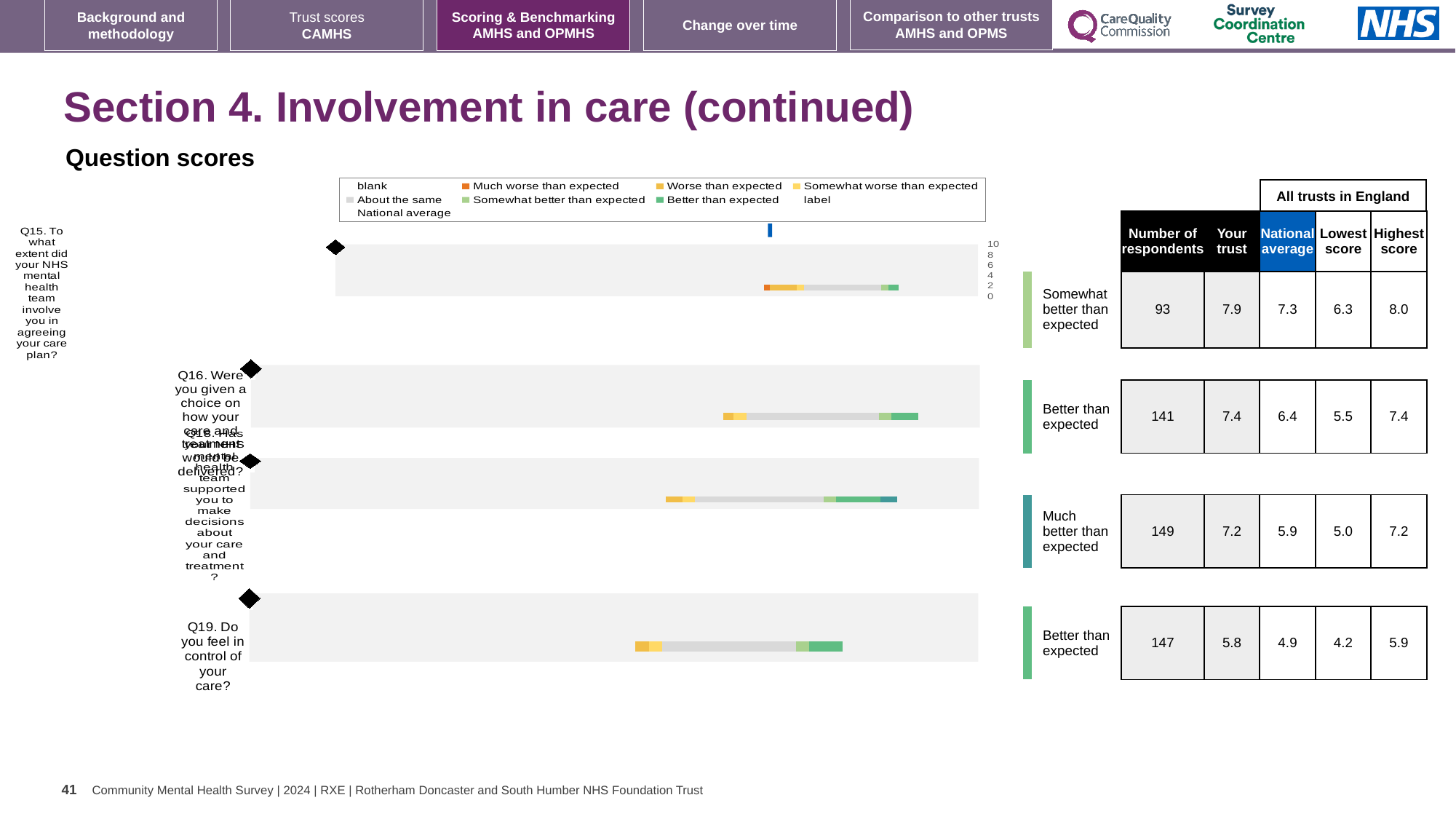
What is the national average for Q19 in the table beside the chart? 4.9 Which question has the highest 'Your trust' score in the table beside the chart? Q15 What is the 'Your trust' score for Q15 in the table beside the chart? 7.9 What is the difference between the 'Your trust' score and the national average for Q16? 1.0 Is the 'Your trust' score for Q18 larger than the 'Your trust' score for Q19? Yes What kind of chart is shown under 'Question scores'? bar chart How many entries does the legend of the Question scores chart list? 9 Which legend entry in the Question scores chart is shown in orange? Much worse than expected What is the number of respondents for Q18 in the table beside the chart? 149 How many questions (bars) are plotted in the Question scores chart? 4 Which question has the lowest number of respondents in the table beside the chart? Q15 What benchmark category is shown for Q18 next to the chart? Much better than expected